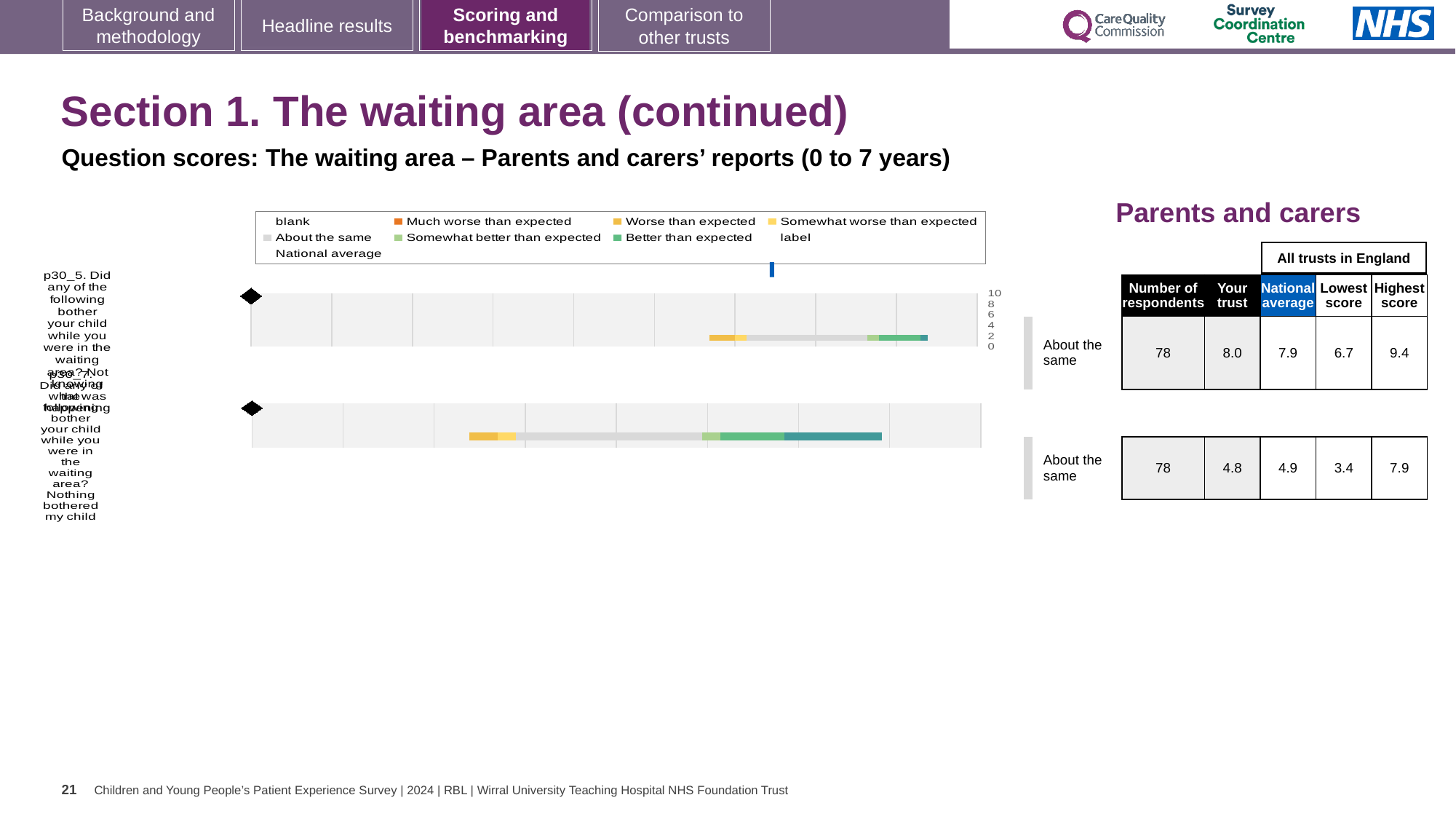
How many bars are plotted in the chart? 2 Which bar has the higher 'Your trust' score, the top bar (p30_5) or the bottom bar (p30_7)? the top bar (p30_5) How many respondents are listed for the top bar (p30_5)? 78 For the top bar (p30_5), what is the difference between the highest score and the lowest score across all trusts in England? 2.7 What kind of chart is shown on the slide? bar chart What colour does the legend use for 'Much worse than expected'? orange According to the table beside the chart, what is the 'Your trust' score for the top bar (p30_5, Not knowing what was happening)? 8.0 What is the lowest score across all trusts in England for the bottom bar (p30_7)? 3.4 What benchmark category is shown next to both bars in the chart? About the same For the top bar (p30_5), which is higher: the 'Your trust' score or the national average? Your trust For the bottom bar (p30_7), what is the difference between the highest score and the lowest score across all trusts in England? 4.5 According to the table beside the chart, what is the national average for the bottom bar (p30_7, Nothing bothered my child)? 4.9